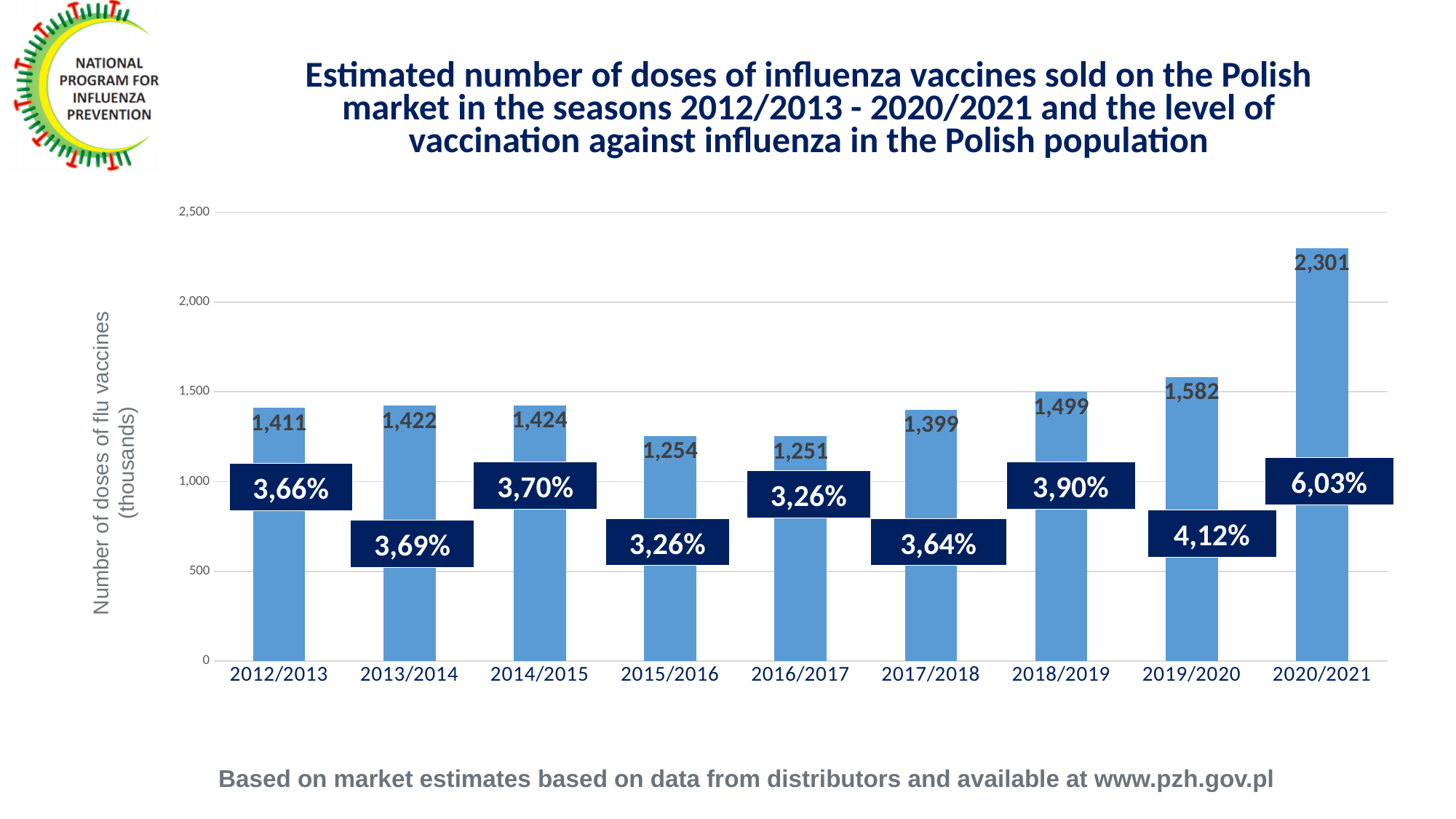
Is the number of doses sold in 2019/2020 greater or less than 1,500? greater What vaccination level is shown for the 2019/2020 season? 4,12% Which season has the highest number of doses sold? 2020/2021 How many seasons are shown on the x axis? 9 Which season had more doses sold, 2017/2018 or 2018/2019? 2018/2019 What vaccination level is shown for the 2014/2015 season? 3,70% What is the difference in doses sold between the 2020/2021 and 2019/2020 seasons? 719 What is the estimated number of doses sold in the 2015/2016 season? 1,254 Which season has the lowest number of doses sold? 2016/2017 What is the estimated number of doses of influenza vaccines sold in the 2020/2021 season? 2,301 What is the label of the vertical axis? Number of doses of flu vaccines (thousands) What kind of chart is shown on the slide? bar chart